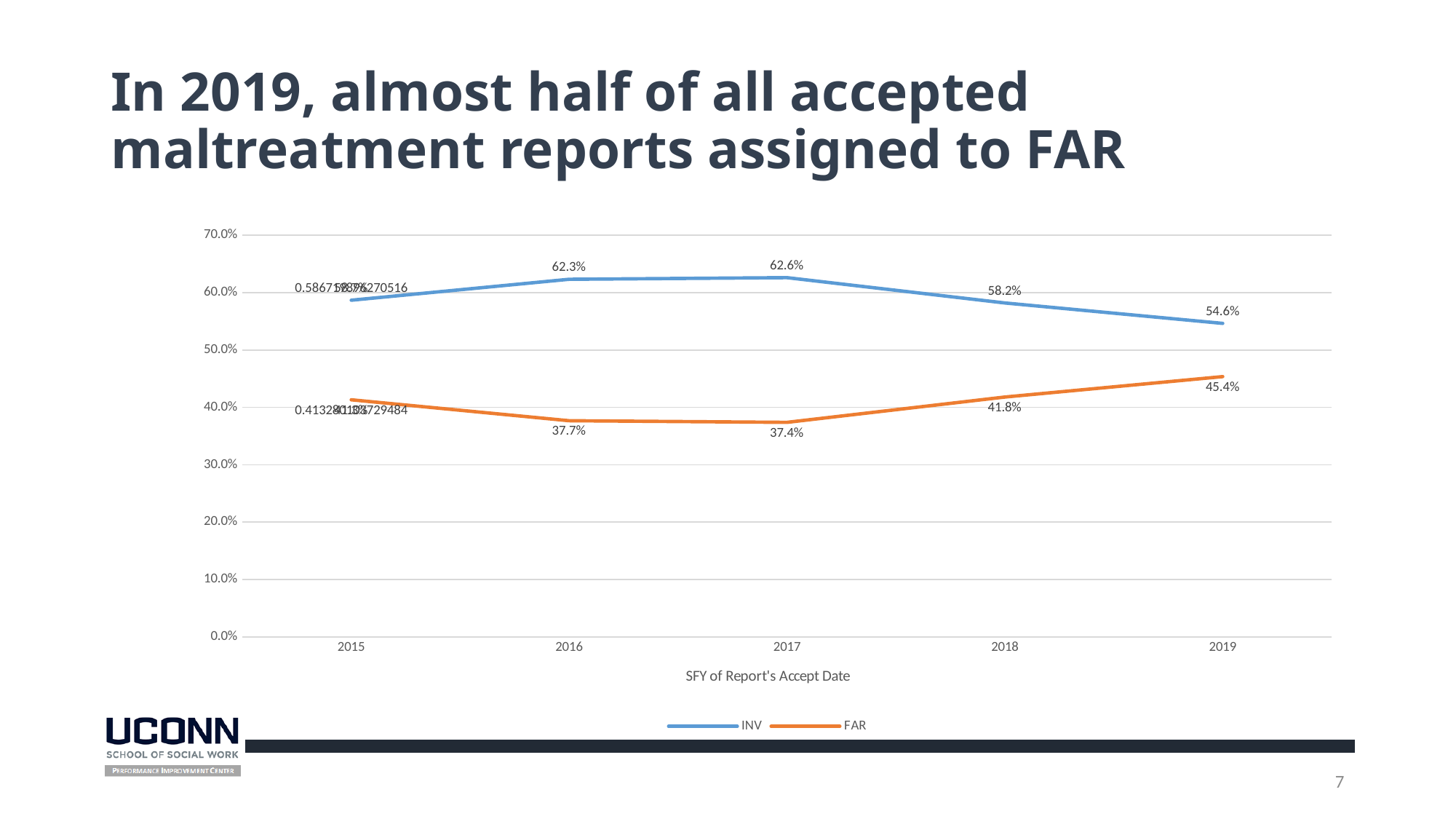
In which year is the FAR series highest? 2019 What is the INV value for 2018? 58.2% How many years are shown on the x axis? 5 How many series does the legend list? 2 What is the INV value for 2019? 54.6% Which is larger in 2018, the INV value or the FAR value? INV What is the FAR value for 2019? 45.4% What kind of chart is shown on the slide? line chart What is the FAR value for 2017? 37.4% In which year is the INV series lowest? 2019 Is the FAR value for 2016 greater or less than 40.0%? less What is the difference between the INV and FAR values in 2019? 9.2%